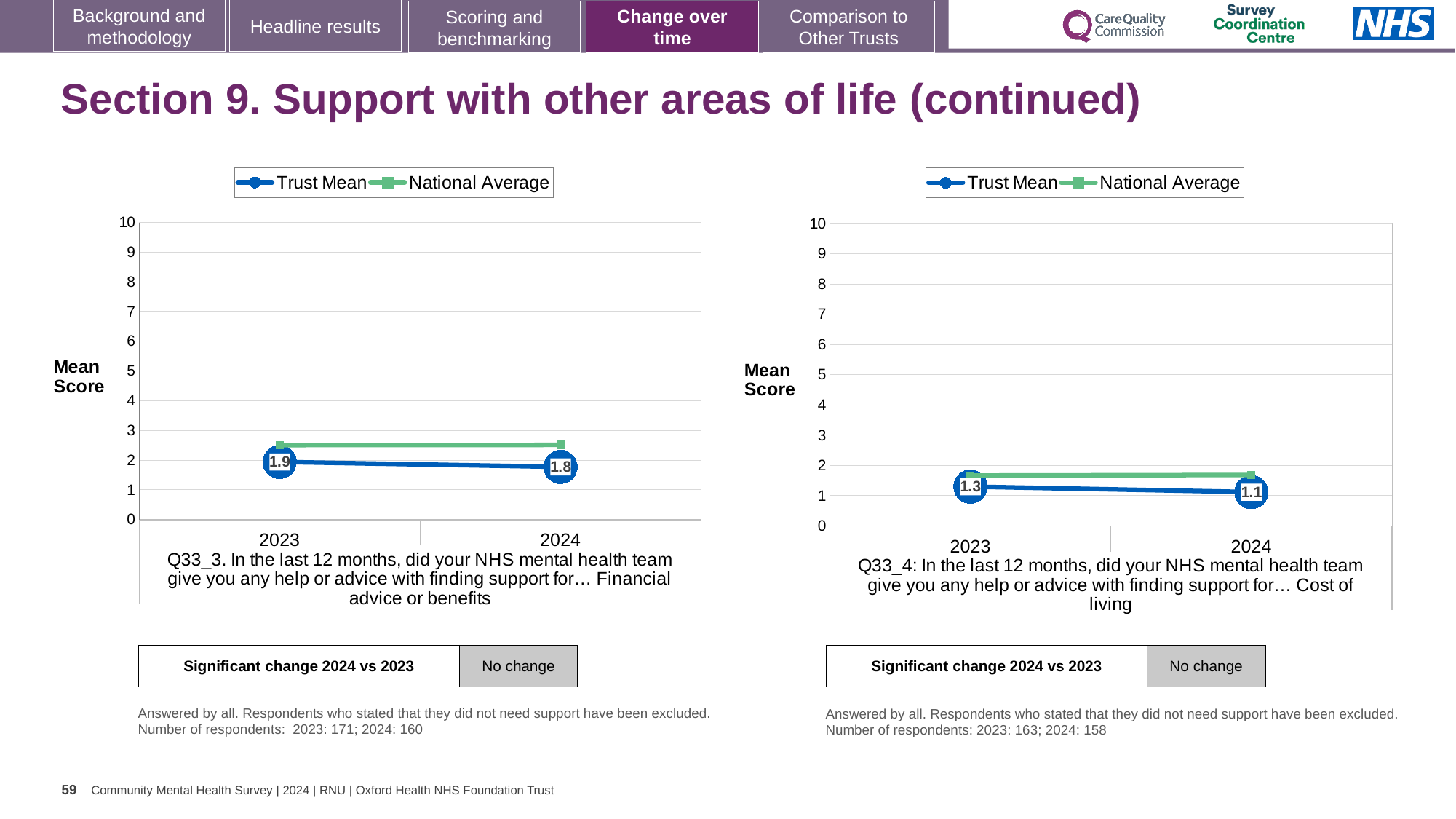
How many series does the legend of the right chart (Q33_4) list? 2 In the left chart (Q33_3, Financial advice or benefits), what is the Trust Mean for 2024? 1.8 In the left chart (Q33_3), by how much did the Trust Mean change from 2023 to 2024? 0.1 In the right chart (Q33_4), which is higher in 2024, the Trust Mean or the National Average? National Average In the right chart (Q33_4), does the Trust Mean rise or fall from 2023 to 2024? fall In the left chart (Q33_3, Financial advice or benefits), what is the Trust Mean for 2023? 1.9 In the left chart (Q33_3), is the National Average for 2024 greater or less than 2? greater In the right chart (Q33_4, Cost of living), what is the Trust Mean for 2023? 1.3 In the right chart (Q33_4, Cost of living), what is the Trust Mean for 2024? 1.1 In the right chart (Q33_4), what is the difference between the Trust Mean in 2023 and 2024? 0.2 How many years are plotted on the x axis of the left chart (Q33_3)? 2 What type of chart is the left chart (Q33_3)? line chart